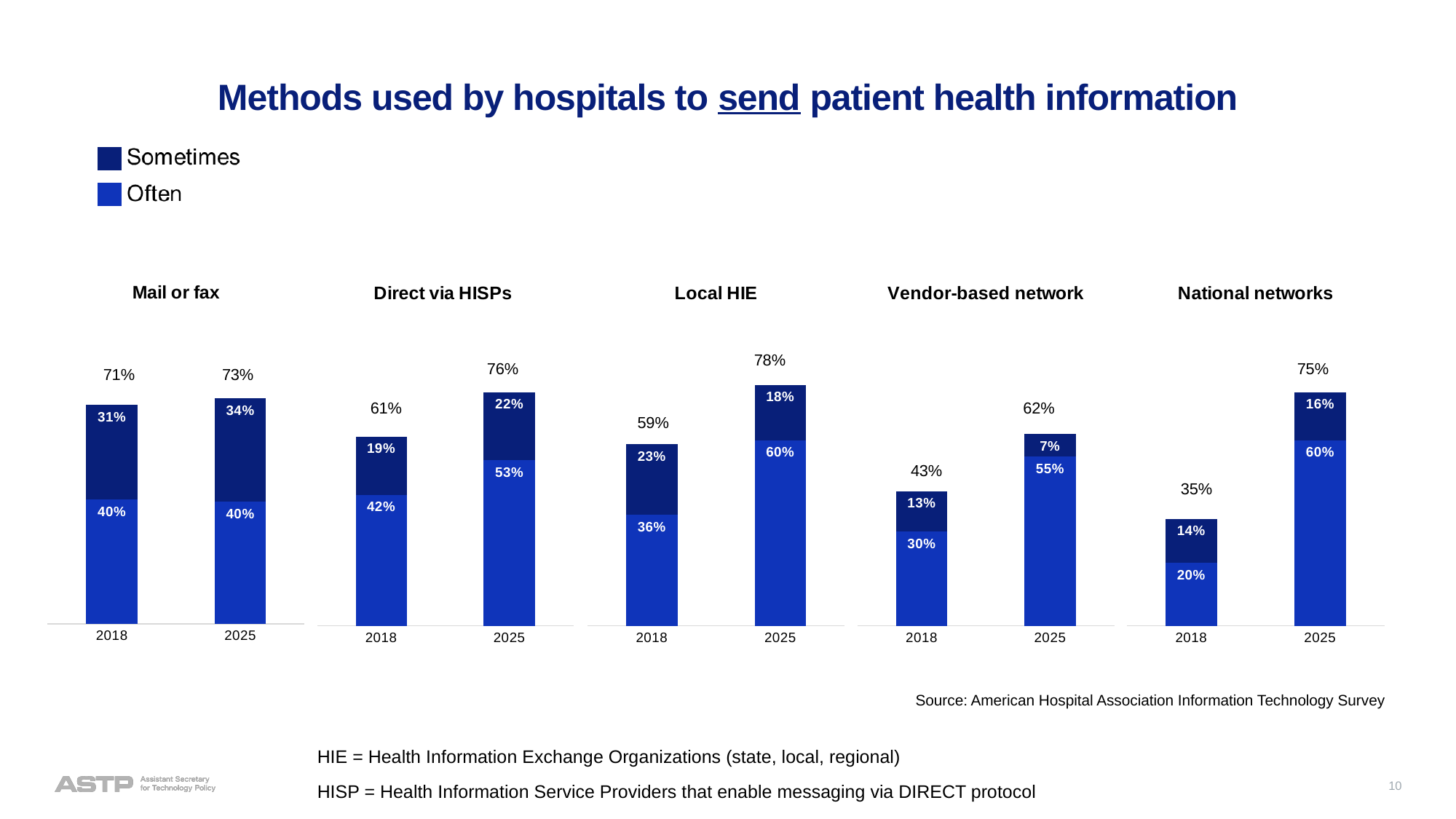
In the National networks chart, what is the difference between the 2025 total and the 2018 total? 40% In the Mail or fax chart, what is the 'Often' value for 2018? 40% What kind of chart is used on this slide? stacked bar chart Which colour represents 'Often' in the legend? lighter blue In the Direct via HISPs chart, what is the 'Sometimes' value for 2025? 22% In the Vendor-based network chart, what is the 'Often' value for 2025? 55% In the Local HIE chart, what is the total for the 2025 stacked bar? 78% In the Direct via HISPs chart, what is the difference between the 'Often' values for 2025 and 2018? 11% In the Vendor-based network chart, which year has the higher total, 2018 or 2025? 2025 In the National networks chart, what is the total for the 2018 stacked bar? 35% In the Local HIE chart, does the total rise or fall from 2018 to 2025? rise How many series does the legend list? 2